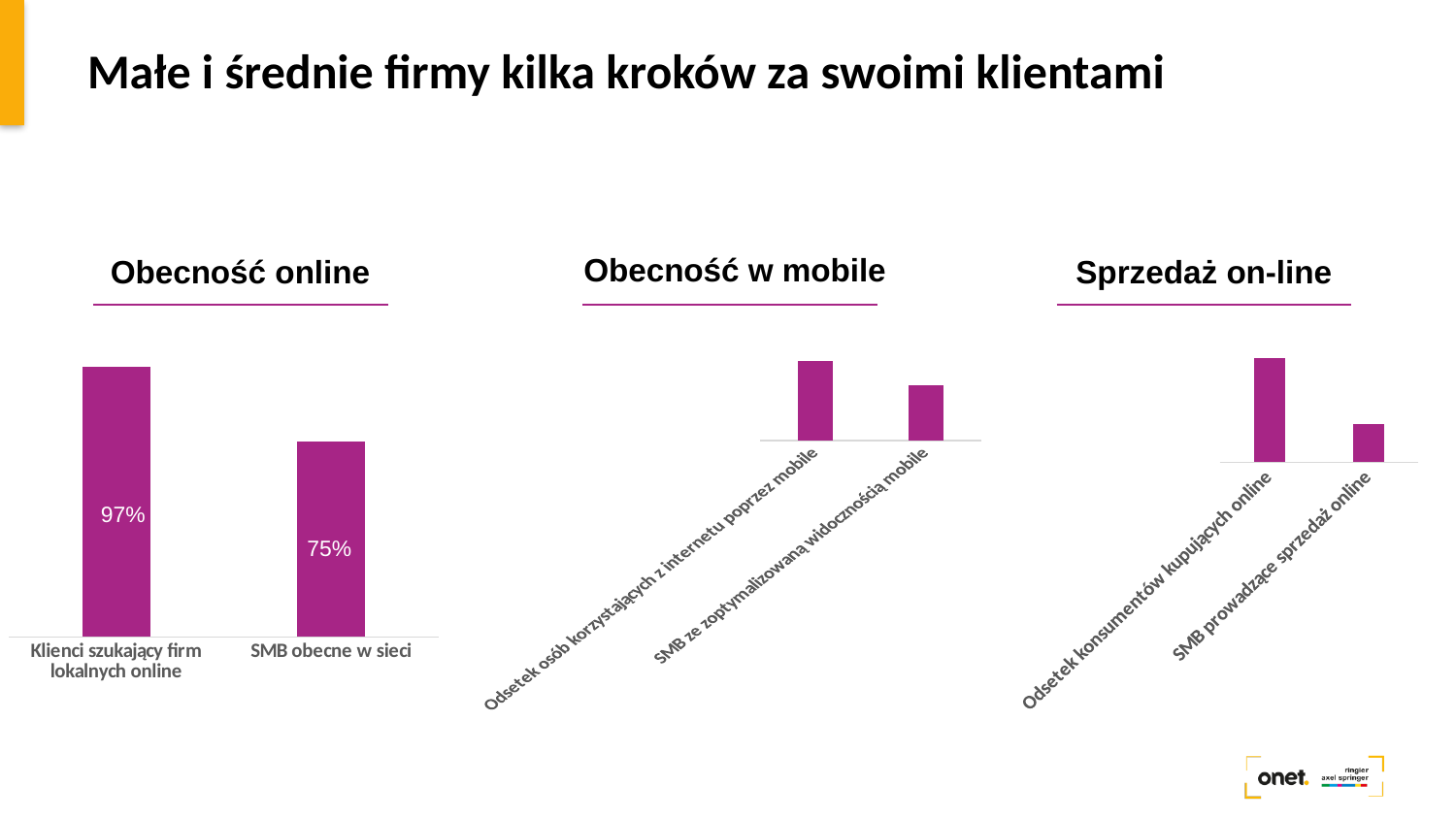
In the 'Obecność online' chart, which category has the higher value? Klienci szukający firm lokalnych online In the 'Obecność w mobile' chart, which category has the taller bar? Odsetek osób korzystających z internetu poprzez mobile In the 'Obecność online' chart, what is the value for 'SMB obecne w sieci'? 75% How many charts are shown on the slide? 3 What is the title of the chart on the right of the slide? Sprzedaż on-line What type of chart is the 'Obecność online' chart? Bar chart In the 'Obecność online' chart, what is the value for 'Klienci szukający firm lokalnych online'? 97% In the 'Sprzedaż on-line' chart, which category has the lowest value? SMB prowadzące sprzedaż online In the 'Obecność online' chart, what is the difference between 'Klienci szukający firm lokalnych online' and 'SMB obecne w sieci'? 22% In the 'Sprzedaż on-line' chart, is the bar for 'Odsetek konsumentów kupujących online' taller or shorter than the bar for 'SMB prowadzące sprzedaż online'? Taller In the 'Obecność online' chart, how many bars are shown? 2 In the 'Obecność w mobile' chart, which category has the lowest value? SMB ze zoptymalizowaną widocznością mobile